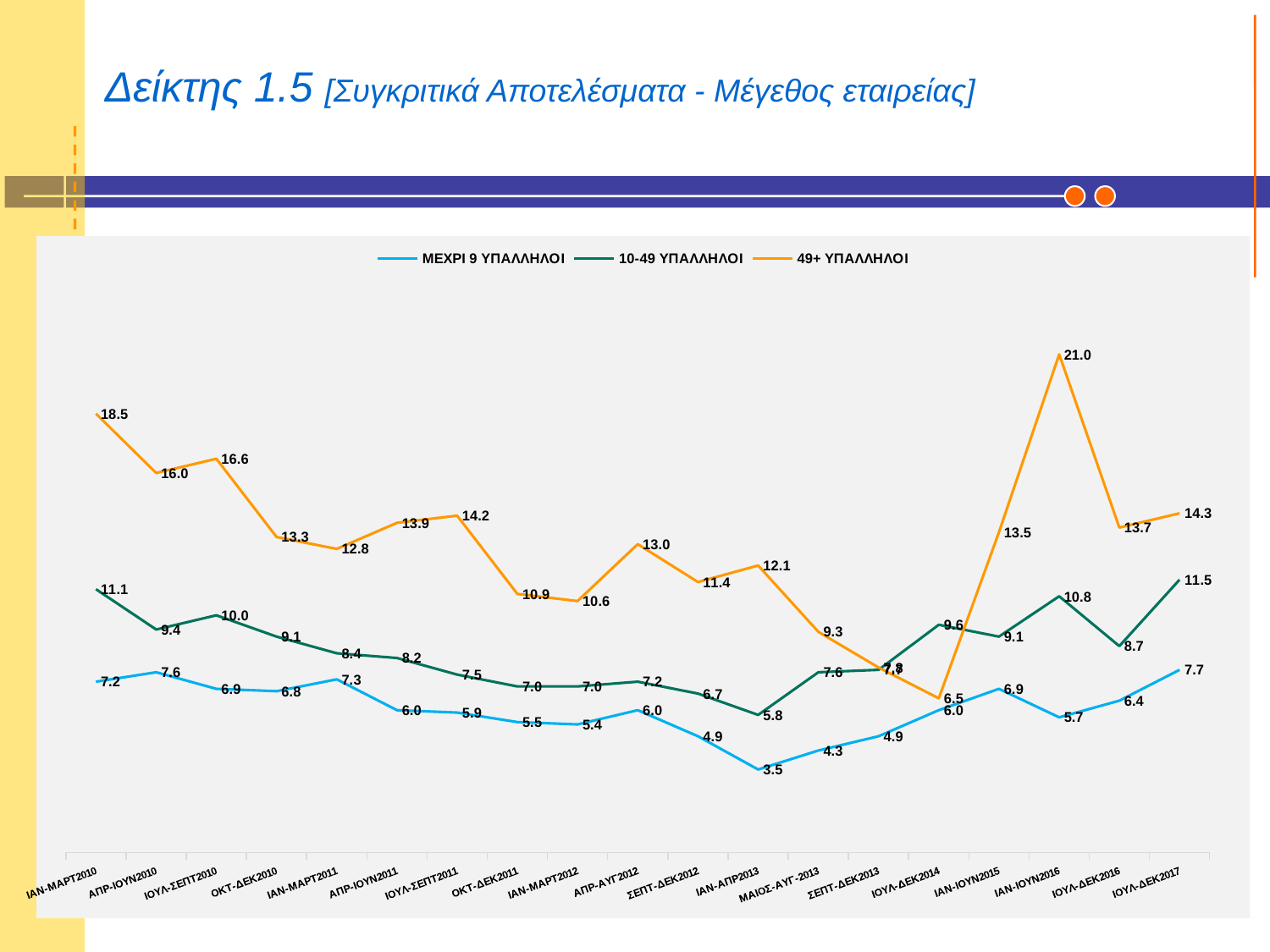
What is the difference between the 49+ ΥΠΑΛΛΗΛΟΙ value in ΙΑΝ-ΜΑΡΤ2010 and in ΑΠΡ-ΙΟΥΝ2010? 2.5 Which series is drawn in orange in the legend? 49+ ΥΠΑΛΛΗΛΟΙ How many time periods are plotted along the x axis? 19 What is the value for ΜΕΧΡΙ 9 ΥΠΑΛΛΗΛΟΙ in ΙΑΝ-ΑΠΡ2013? 3.5 Which series has the higher value in ΙΟΥΛ-ΔΕΚ2014: 10-49 ΥΠΑΛΛΗΛΟΙ or 49+ ΥΠΑΛΛΗΛΟΙ? 10-49 ΥΠΑΛΛΗΛΟΙ Does the 49+ ΥΠΑΛΛΗΛΟΙ series rise or fall from ΙΑΝ-ΙΟΥΝ2016 to ΙΟΥΛ-ΔΕΚ2016? Fall What is the value for 10-49 ΥΠΑΛΛΗΛΟΙ in ΙΟΥΛ-ΔΕΚ2017? 11.5 What is the value for 49+ ΥΠΑΛΛΗΛΟΙ in ΙΑΝ-ΙΟΥΝ2016? 21.0 In which period does the 49+ ΥΠΑΛΛΗΛΟΙ series reach its highest value? ΙΑΝ-ΙΟΥΝ2016 In which period does the ΜΕΧΡΙ 9 ΥΠΑΛΛΗΛΟΙ series reach its lowest value? ΙΑΝ-ΑΠΡ2013 How many series does the legend list? 3 What type of chart is shown on the slide? Line chart